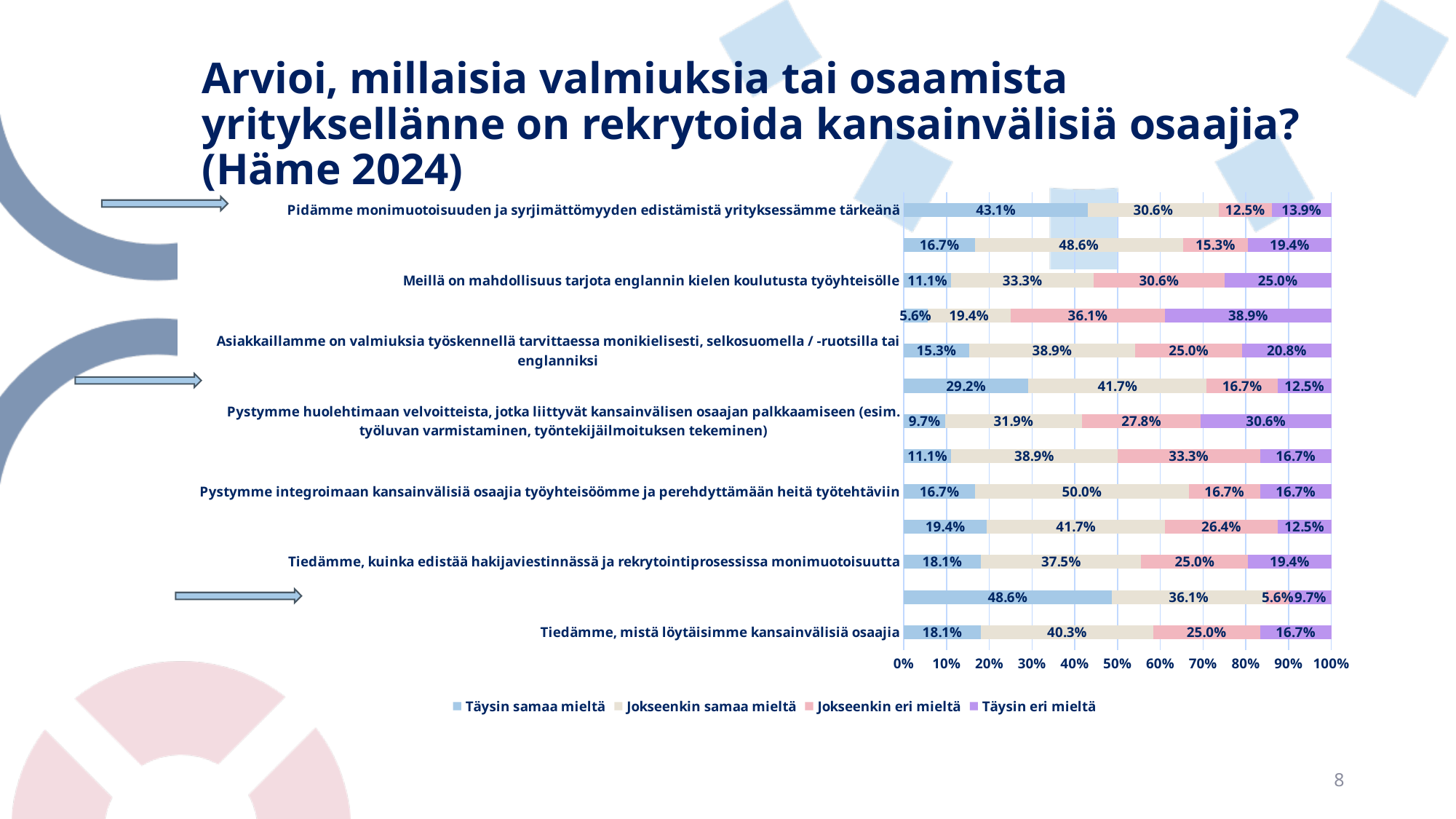
What is the difference between the 'Täysin samaa mieltä' and 'Jokseenkin samaa mieltä' values for 'Pidämme monimuotoisuuden ja syrjimättömyyden edistämistä yrityksessämme tärkeänä'? 12.5 percentage points In the bar for 'Pidämme monimuotoisuuden ja syrjimättömyyden edistämistä yrityksessämme tärkeänä', which series has the largest share? Täysin samaa mieltä What colour represents 'Täysin eri mieltä' in the chart? Purple What is the 'Täysin samaa mieltä' value for 'Pystymme huolehtimaan velvoitteista, jotka liittyvät kansainvälisen osaajan palkkaamiseen'? 9.7% How many series does the legend list? 4 In the bar for 'Pystymme huolehtimaan velvoitteista, jotka liittyvät kansainvälisen osaajan palkkaamiseen', which series has the smallest share? Täysin samaa mieltä What is the 'Jokseenkin eri mieltä' value for 'Tiedämme, mistä löytäisimme kansainvälisiä osaajia'? 25.0% What is the 'Jokseenkin samaa mieltä' value for 'Pystymme integroimaan kansainvälisiä osaajia työyhteisöömme ja perehdyttämään heitä työtehtäviin'? 50.0% What kind of chart is shown on the slide? Stacked bar chart Which has a larger 'Täysin samaa mieltä' value: 'Pidämme monimuotoisuuden ja syrjimättömyyden edistämistä yrityksessämme tärkeänä' or 'Tiedämme, mistä löytäisimme kansainvälisiä osaajia'? Pidämme monimuotoisuuden ja syrjimättömyyden edistämistä yrityksessämme tärkeänä What is the 'Täysin eri mieltä' value for 'Meillä on mahdollisuus tarjota englannin kielen koulutusta työyhteisölle'? 25.0% What is the 'Täysin samaa mieltä' value for 'Pidämme monimuotoisuuden ja syrjimättömyyden edistämistä yrityksessämme tärkeänä'? 43.1%